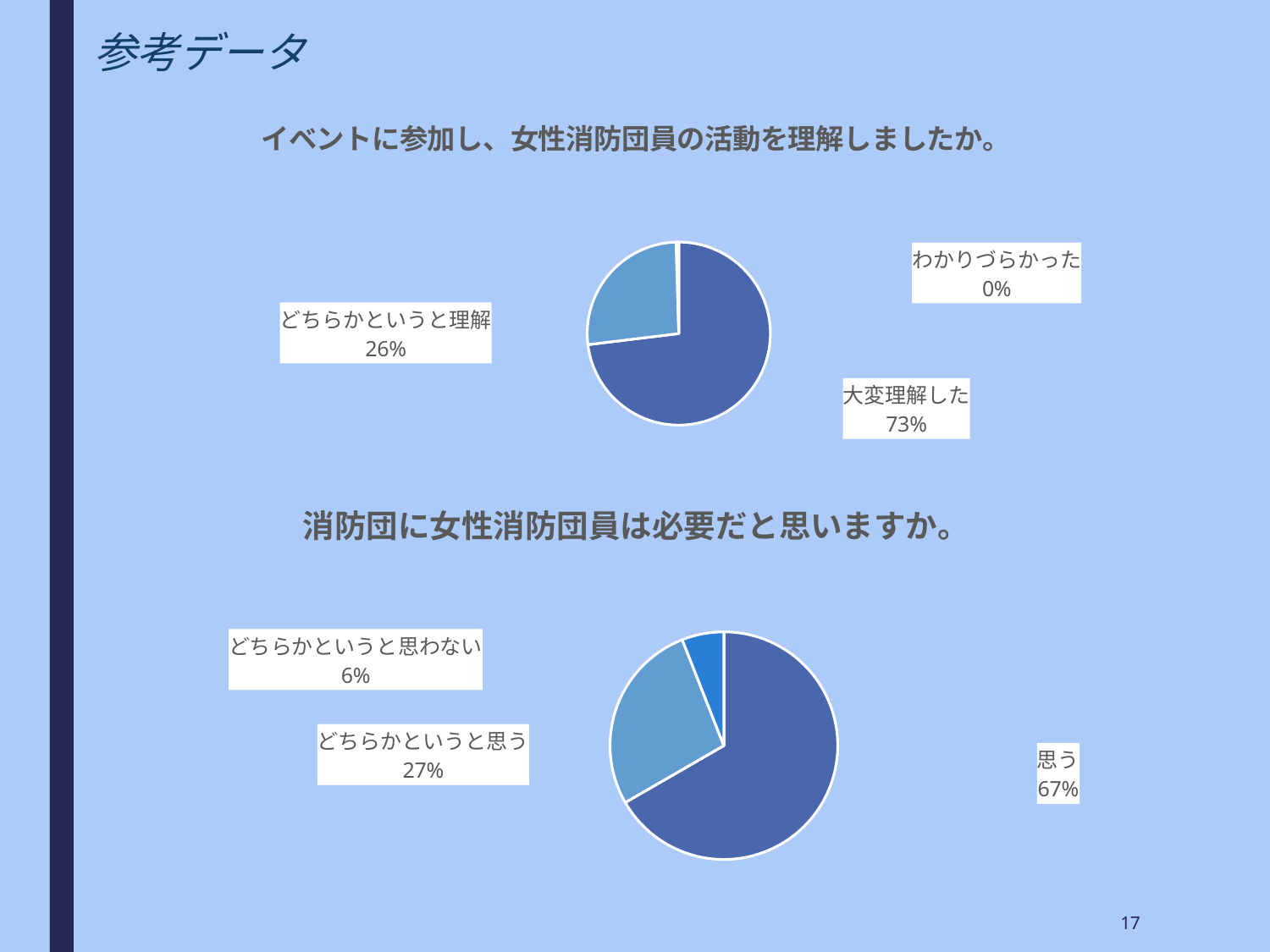
How many labelled categories does the bottom chart show? 3 In the bottom chart (消防団に女性消防団員は必要だと思いますか。), what share of respondents answered 思う? 67% What type of chart is used for the top chart on the slide? Pie chart In the top chart, which response has the largest share? 大変理解した In the top chart, what percentage is shown for どちらかというと理解? 26% In the top chart, what is the difference in percentage points between 大変理解した and どちらかというと理解? 47 In the top chart (イベントに参加し、女性消防団員の活動を理解しましたか。), what share of respondents answered 大変理解した? 73% In the bottom chart, which is larger: 思う or どちらかというと思う? 思う In the bottom chart, what percentage is shown for どちらかというと思わない? 6% In the bottom chart, which response has the smallest share? どちらかというと思わない In the top chart, what percentage is shown for わかりづらかった? 0% In the bottom chart, what percentage is shown for どちらかというと思う? 27%